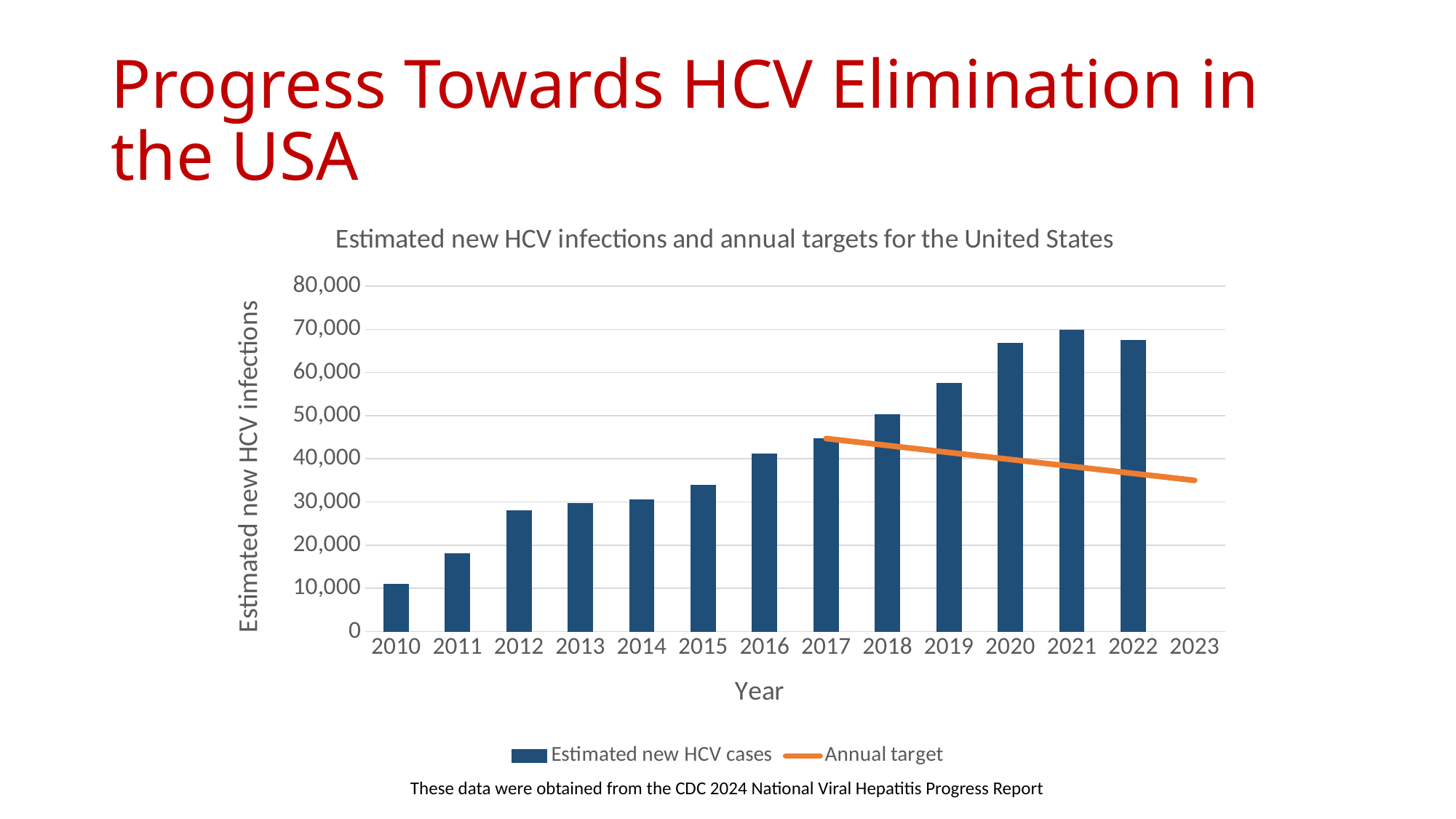
Is the value for estimated new HCV cases in 2016 greater or less than 40,000? greater Do the estimated new HCV cases generally rise or fall from 2010 to 2021? rise Which is larger, the estimated new HCV cases in 2019 or in 2018? 2019 Which year has the highest number of estimated new HCV cases? 2021 Is the value for estimated new HCV cases in 2010 greater or less than 20,000? less How many series does the legend list? 2 What kind of chart is shown on the slide? Bar chart with a line How many years have a bar for estimated new HCV cases? 13 What is the title of the chart? Estimated new HCV infections and annual targets for the United States Is the value for estimated new HCV cases in 2020 greater or less than 60,000? greater Which year has the lowest number of estimated new HCV cases? 2010